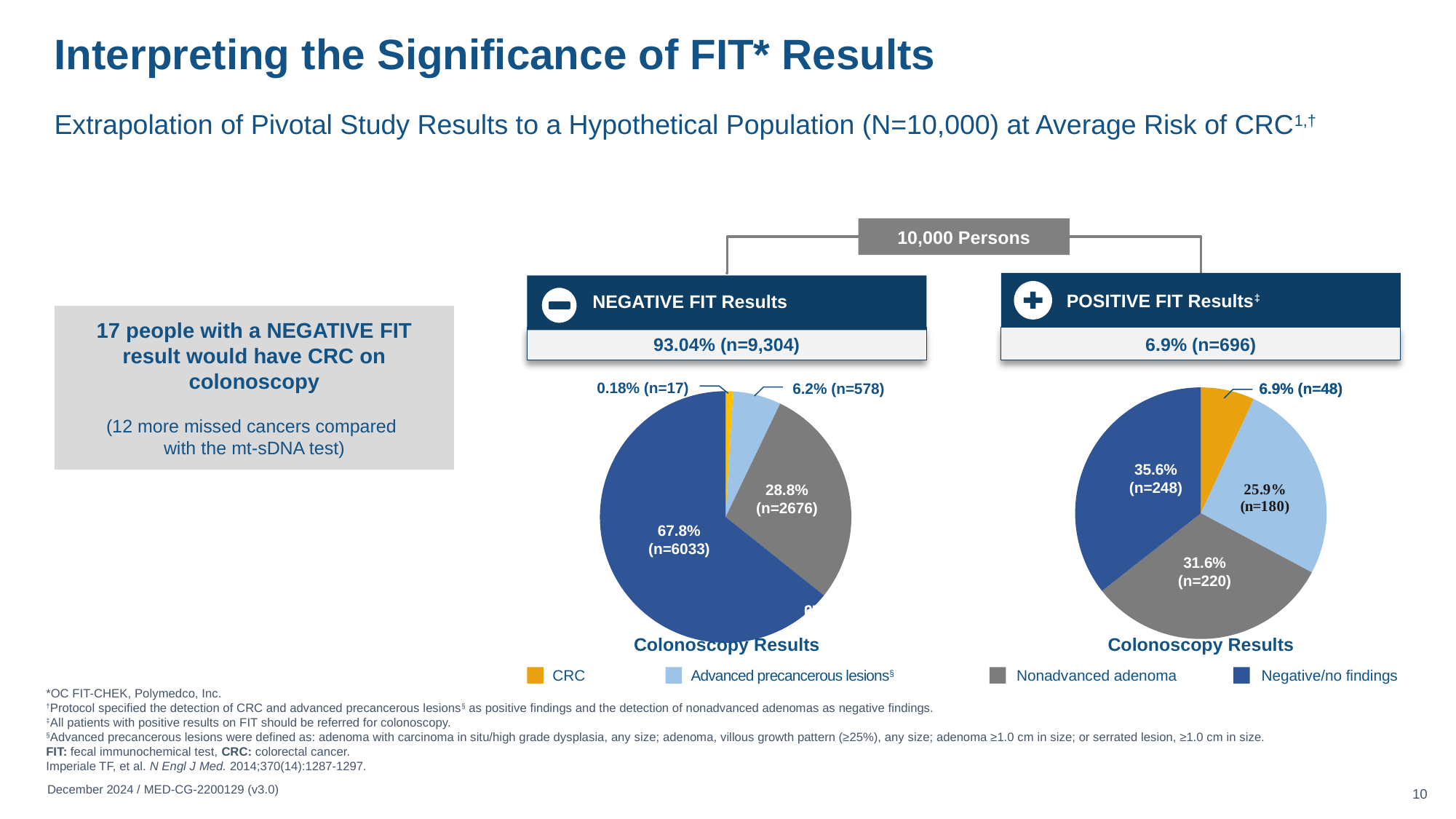
In the NEGATIVE FIT Results pie chart, which category has the smallest share? CRC In the NEGATIVE FIT Results pie chart, which category has the largest share? Negative/no findings In the POSITIVE FIT Results pie chart, which is larger: Nonadvanced adenoma or CRC? Nonadvanced adenoma How many categories does the shared legend list for the pie charts? 4 In the POSITIVE FIT Results pie chart, which category has the smallest share? CRC In the POSITIVE FIT Results pie chart, what is the value for Negative/no findings? 35.6% (n=248) In the NEGATIVE FIT Results pie chart, what percentage of people had CRC on colonoscopy? 0.18% (n=17) What type of chart is used to show the colonoscopy results for the NEGATIVE FIT Results group? Pie chart In the POSITIVE FIT Results pie chart, what is the difference in number of people between Nonadvanced adenoma and Advanced precancerous lesions? 40 In the POSITIVE FIT Results pie chart, what is the value for Advanced precancerous lesions? 25.9% (n=180) Which colour represents CRC in the pie charts? Orange In the NEGATIVE FIT Results pie chart, what is the value for Nonadvanced adenoma? 28.8% (n=2676)